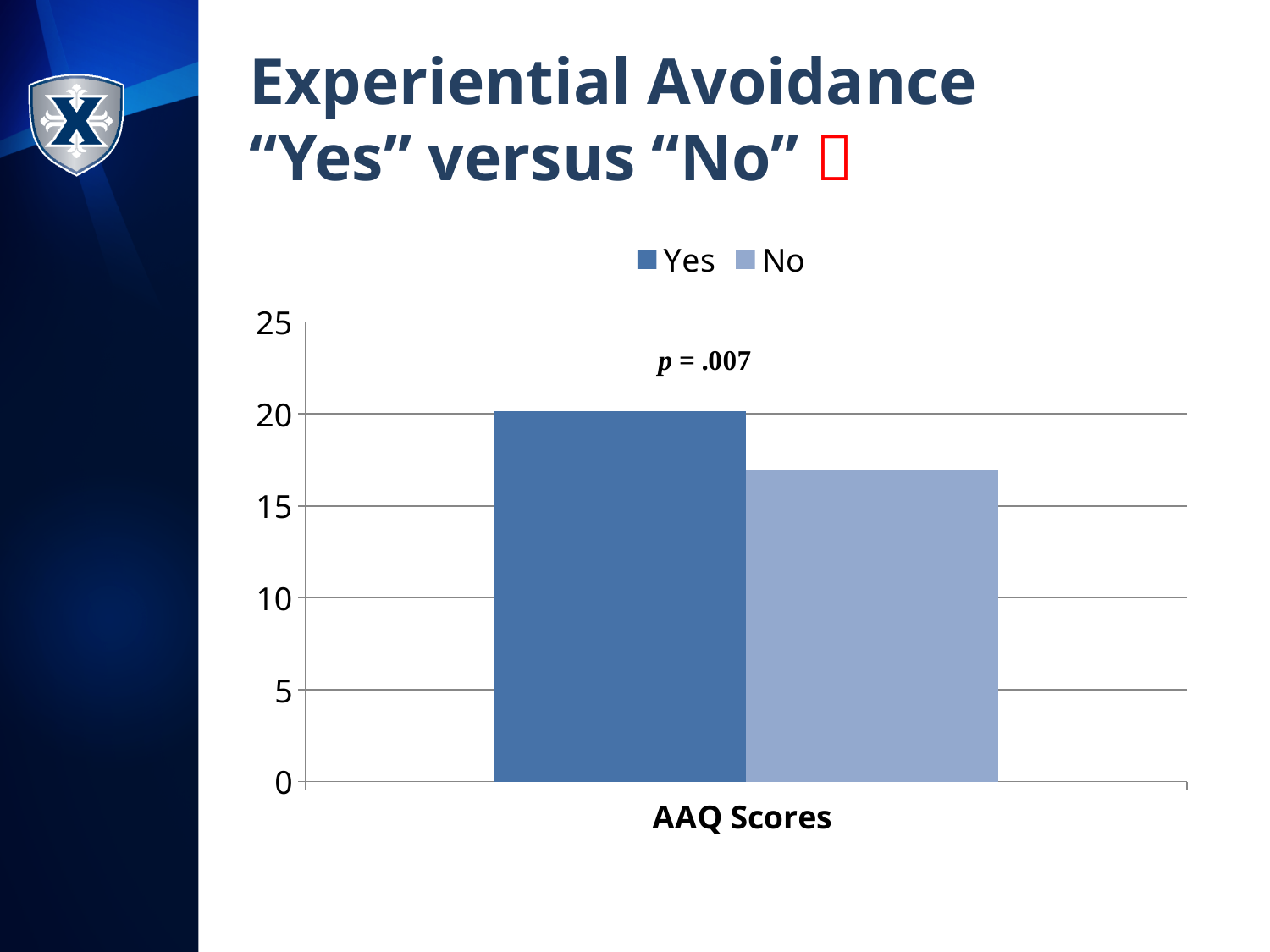
How many categories are shown on the x axis? 1 Which series has the lowest bar for AAQ Scores? No Which series has the higher AAQ Scores bar, Yes or No? Yes Is the AAQ Scores value for No greater or less than 15? greater What is the label on the x axis of the chart? AAQ Scores What p value is annotated on the chart? p = .007 How many series does the legend list? 2 Is the AAQ Scores value for Yes greater or less than 15? greater What kind of chart is shown on the slide? bar chart Is the AAQ Scores value for No greater or less than 20? less